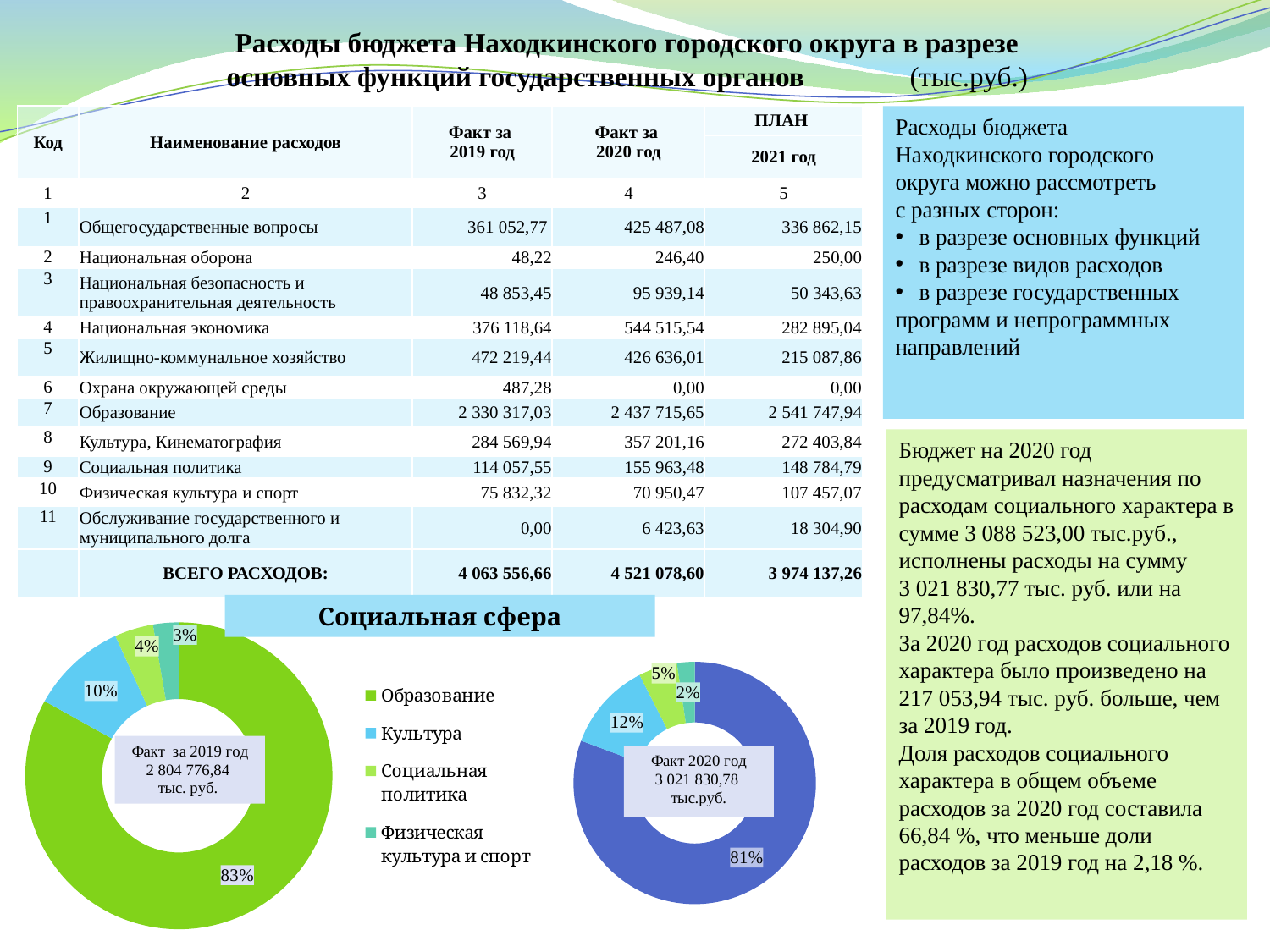
In the left doughnut chart (Факт за 2019 год), what is the difference between the 83% slice and the 10% slice? 73% In the left doughnut chart (Факт за 2019 год), what share does the largest slice have? 83% How many charts are shown under the heading 'Социальная сфера'? 2 In the right doughnut chart (Факт 2020 год), what is the smallest slice's share? 2% What kind of chart is used for the 'Социальная сфера' section of the slide? Doughnut (pie) chart Which is larger: the 10% slice in the 2019 chart or the 12% slice in the 2020 chart? The 12% slice in the 2020 chart What total amount is printed in the centre of the right doughnut chart (Факт 2020 год)? 3 021 830,78 тыс.руб. In the left doughnut chart (Факт за 2019 год), which category has the largest share? Образование In the right doughnut chart (Факт 2020 год), what share does the largest slice have? 81% How many categories does the legend of the 'Социальная сфера' charts list? 4 What total amount is printed in the centre of the left doughnut chart (Факт за 2019 год)? 2 804 776,84 тыс. руб. In the left doughnut chart (Факт за 2019 год), what is the smallest slice's share? 3%